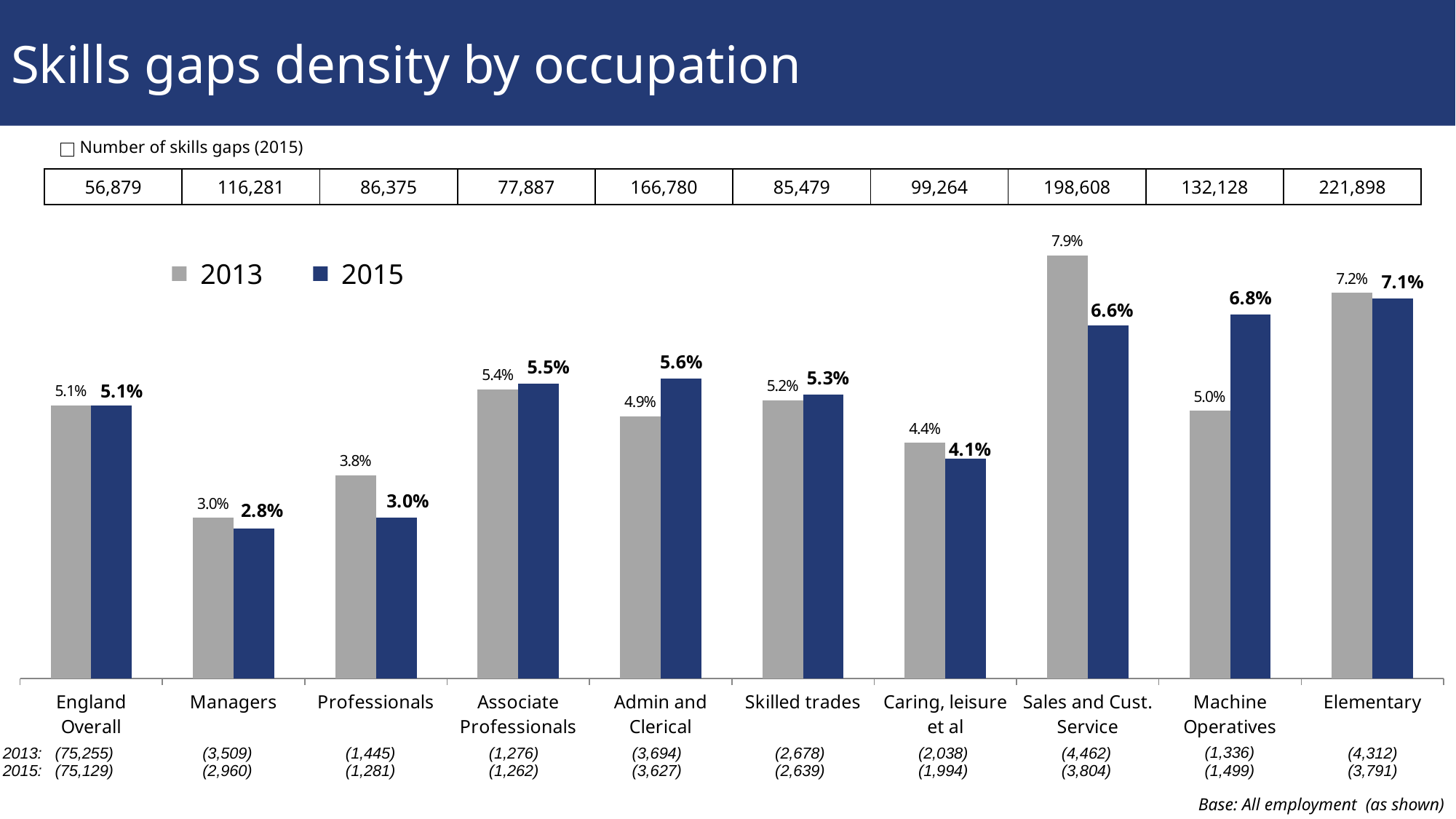
What kind of chart is shown on the slide? Bar chart Which occupation has the lowest 2015 skills gap density? Managers How many occupation categories are shown on the x axis? 10 What is the 2015 skills gap density for Sales and Cust. Service? 6.6% What is the 2015 skills gap density for Machine Operatives? 6.8% What is the title of the slide? Skills gaps density by occupation Which is larger for Machine Operatives: the 2013 value or the 2015 value? 2015 What is the 2013 skills gap density for Professionals? 3.8% What is the number of skills gaps (2015) shown for Elementary? 221,898 Which occupation has the highest 2013 skills gap density? Sales and Cust. Service What is the difference between the 2013 and 2015 skills gap density for Sales and Cust. Service? 1.3% How many series does the legend list? 2